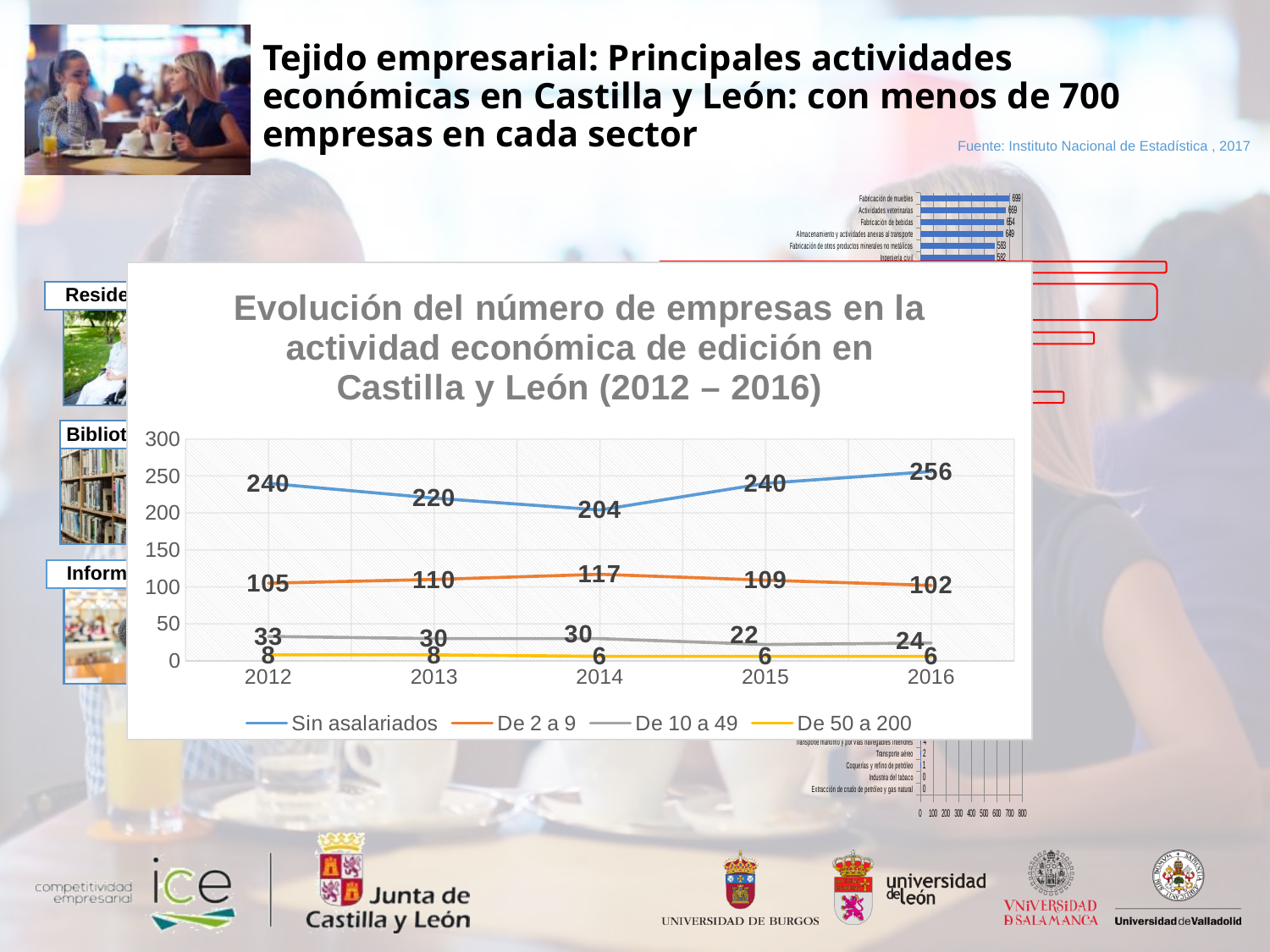
What kind of chart is 'Evolución del número de empresas en la actividad económica de edición en Castilla y León (2012 – 2016)'? Line chart In the chart 'Evolución del número de empresas en la actividad económica de edición en Castilla y León (2012 – 2016)', what is the value for 'De 50 a 200' in 2013? 8 In the chart 'Evolución del número de empresas en la actividad económica de edición en Castilla y León (2012 – 2016)', does the 'De 50 a 200' series rise or fall from 2012 to 2016? Fall In the chart 'Evolución del número de empresas en la actividad económica de edición en Castilla y León (2012 – 2016)', in which year is the 'Sin asalariados' series lowest? 2014 In the chart 'Evolución del número de empresas en la actividad económica de edición en Castilla y León (2012 – 2016)', what is the value for 'De 2 a 9' in 2014? 117 In the chart 'Evolución del número de empresas en la actividad económica de edición en Castilla y León (2012 – 2016)', what is the difference between the 'Sin asalariados' values in 2016 and 2012? 16 In the chart 'Evolución del número de empresas en la actividad económica de edición en Castilla y León (2012 – 2016)', in which year is the 'De 2 a 9' series highest? 2014 In the chart 'Evolución del número de empresas en la actividad económica de edición en Castilla y León (2012 – 2016)', how many years are shown on the x axis? 5 In the chart 'Evolución del número de empresas en la actividad económica de edición en Castilla y León (2012 – 2016)', what is the value for 'De 10 a 49' in 2015? 22 In the chart 'Evolución del número de empresas en la actividad económica de edición en Castilla y León (2012 – 2016)', how many series does the legend list? 4 In the chart 'Evolución del número de empresas en la actividad económica de edición en Castilla y León (2012 – 2016)', which is larger: 'De 10 a 49' in 2012 or 'De 10 a 49' in 2016? 2012 In the chart 'Evolución del número de empresas en la actividad económica de edición en Castilla y León (2012 – 2016)', what is the value for 'Sin asalariados' in 2016? 256